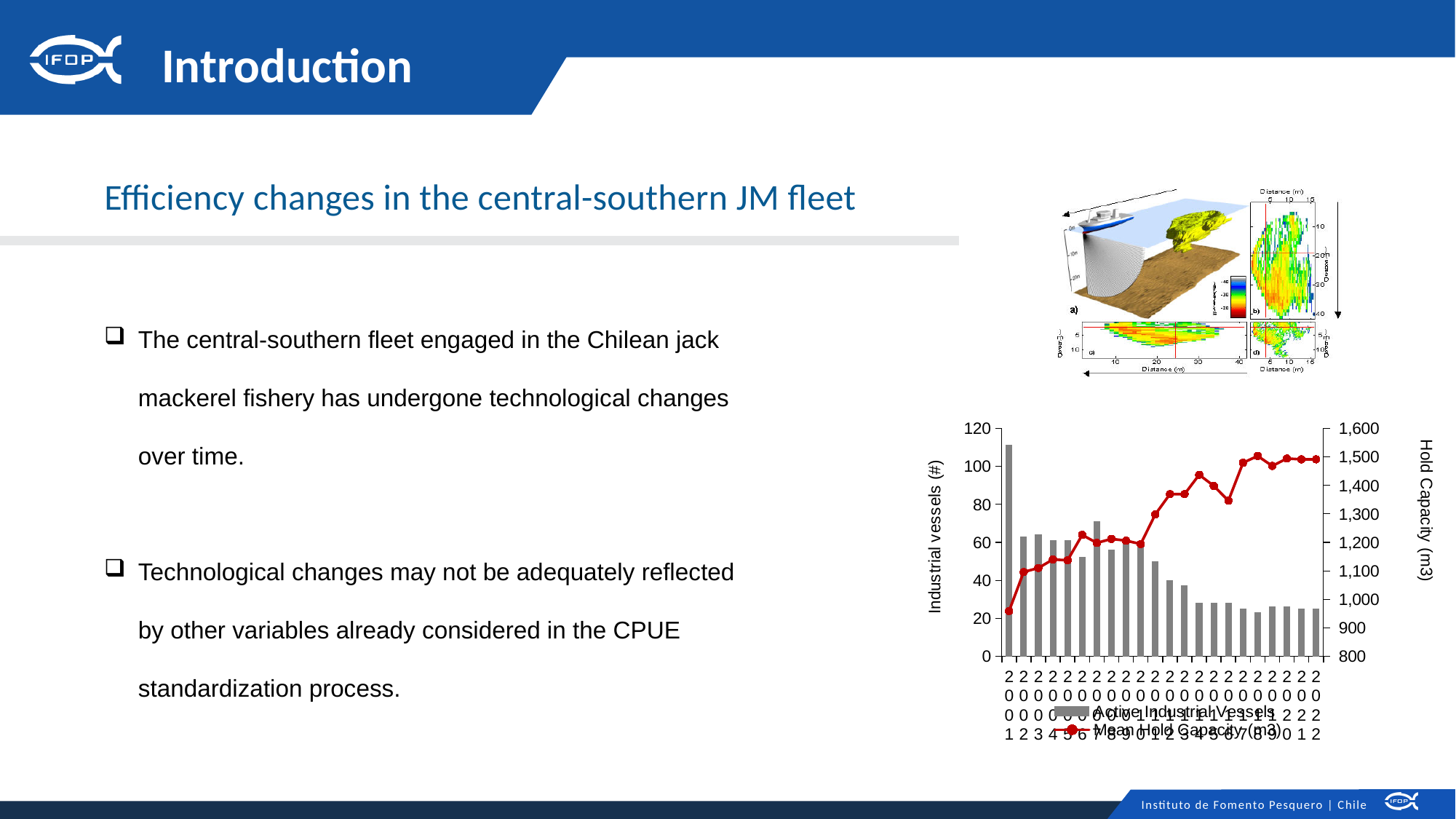
Is the Mean Hold Capacity (m3) in 2001 greater or less than 1,000? less Does the Mean Hold Capacity (m3) generally rise or fall from 2001 to 2022? rise Which year has more Active Industrial Vessels, 2001 or 2022? 2001 Is the Mean Hold Capacity (m3) in 2022 greater or less than 1,400? greater How many years are shown on the x axis of the chart? 22 How many series does the legend of the chart list? 2 What kind of chart is shown at the bottom right of the slide? A combination bar and line chart Is the number of Active Industrial Vessels in 2001 greater or less than 100? greater Which year has the highest number of Active Industrial Vessels? 2001 What is the label of the left vertical axis of the chart? Industrial vessels (#) Which year has the lowest Mean Hold Capacity (m3)? 2001